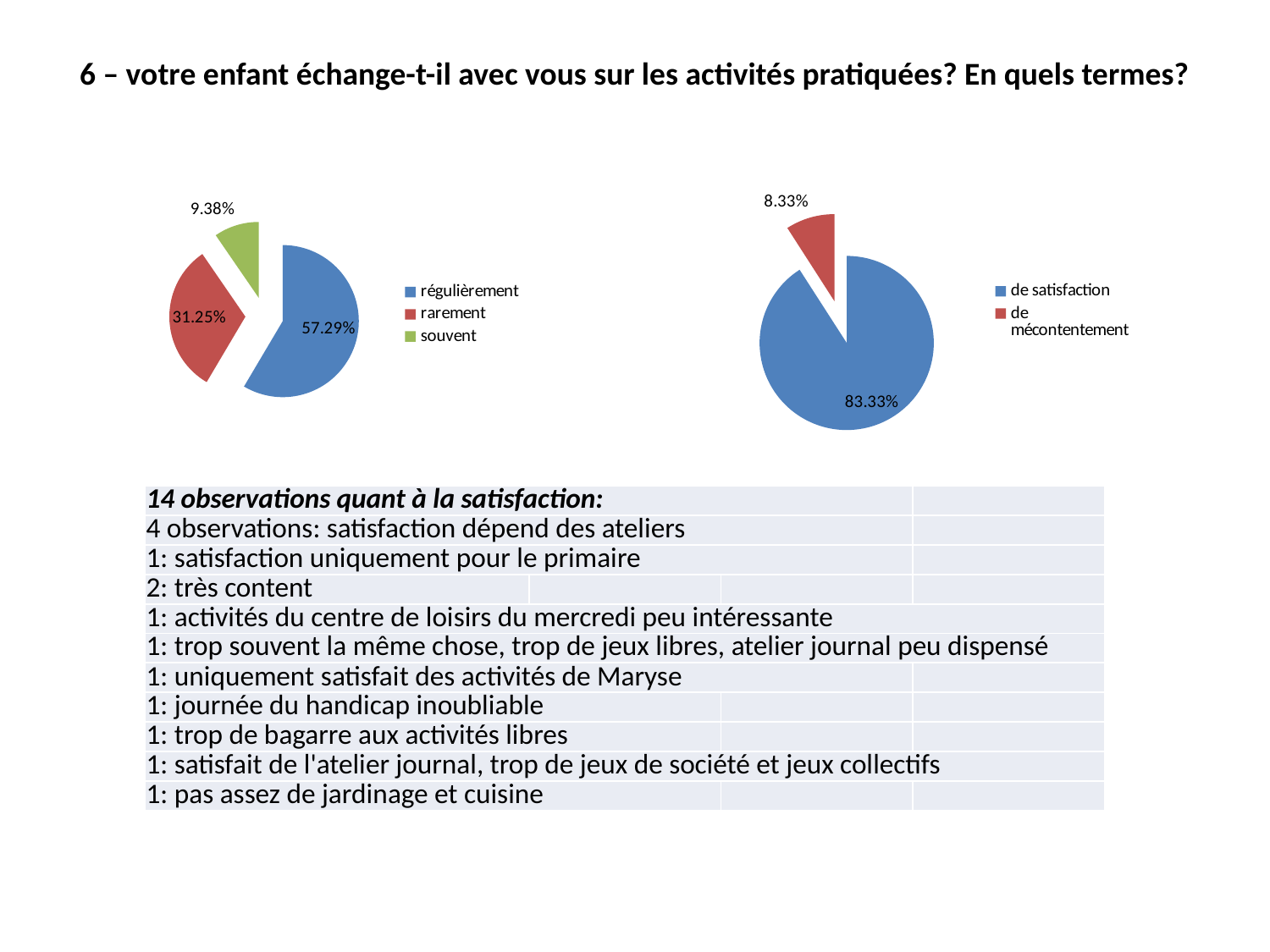
What type of chart is the right chart on the slide? pie chart In the right pie chart, what is the value for "de satisfaction"? 83.33% In the left pie chart, what is the value for "régulièrement"? 57.29% In the left pie chart, what is the value for "souvent"? 9.38% In the left pie chart, which category has the smallest slice? souvent In the left pie chart, what is the difference between the values for "régulièrement" and "rarement"? 26.04% In the right pie chart, which is larger, "de satisfaction" or "de mécontentement"? de satisfaction In the right pie chart, what is the value for "de mécontentement"? 8.33% In the left pie chart, what is the value for "rarement"? 31.25% In the left pie chart, what colour is the "rarement" slice? red In the left pie chart, which category has the largest slice? régulièrement In the left pie chart, how many categories are shown in the legend? 3